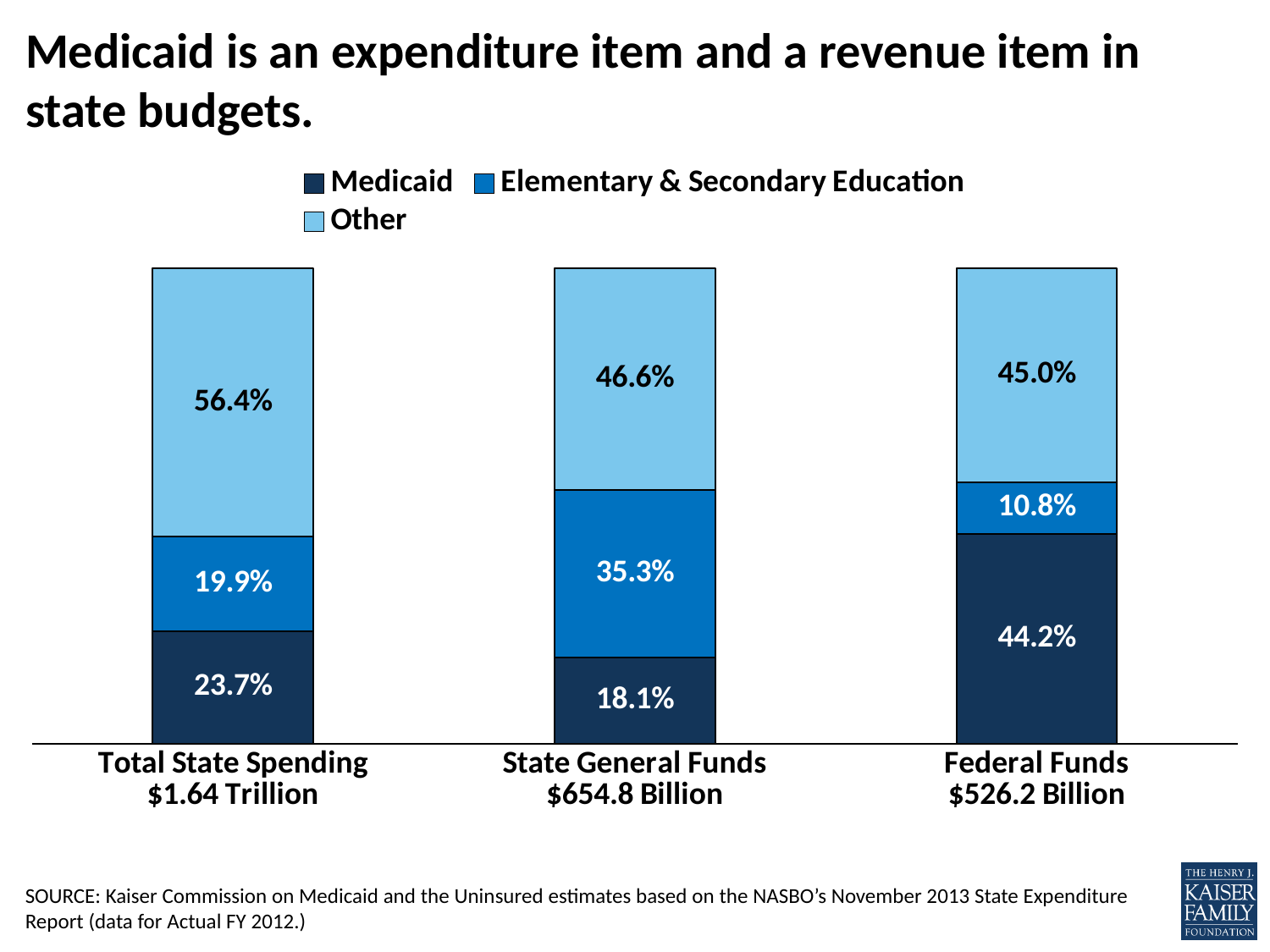
What is the Medicaid share of Total State Spending? 23.7% Which category has the lowest Elementary & Secondary Education share? Federal Funds What total dollar amount is shown under the State General Funds category label? $654.8 Billion How many series does the legend list? 3 What is the Other share of Federal Funds? 45.0% Which is larger: the Other share of Total State Spending or the Other share of State General Funds? Total State Spending What kind of chart is shown on the slide? Stacked bar chart How many categories are shown on the x axis? 3 What is the difference between the Medicaid share of Federal Funds and the Medicaid share of State General Funds? 26.1% What is the Elementary & Secondary Education share of State General Funds? 35.3% What is the Medicaid share of Federal Funds? 44.2% Which category has the highest Medicaid share? Federal Funds